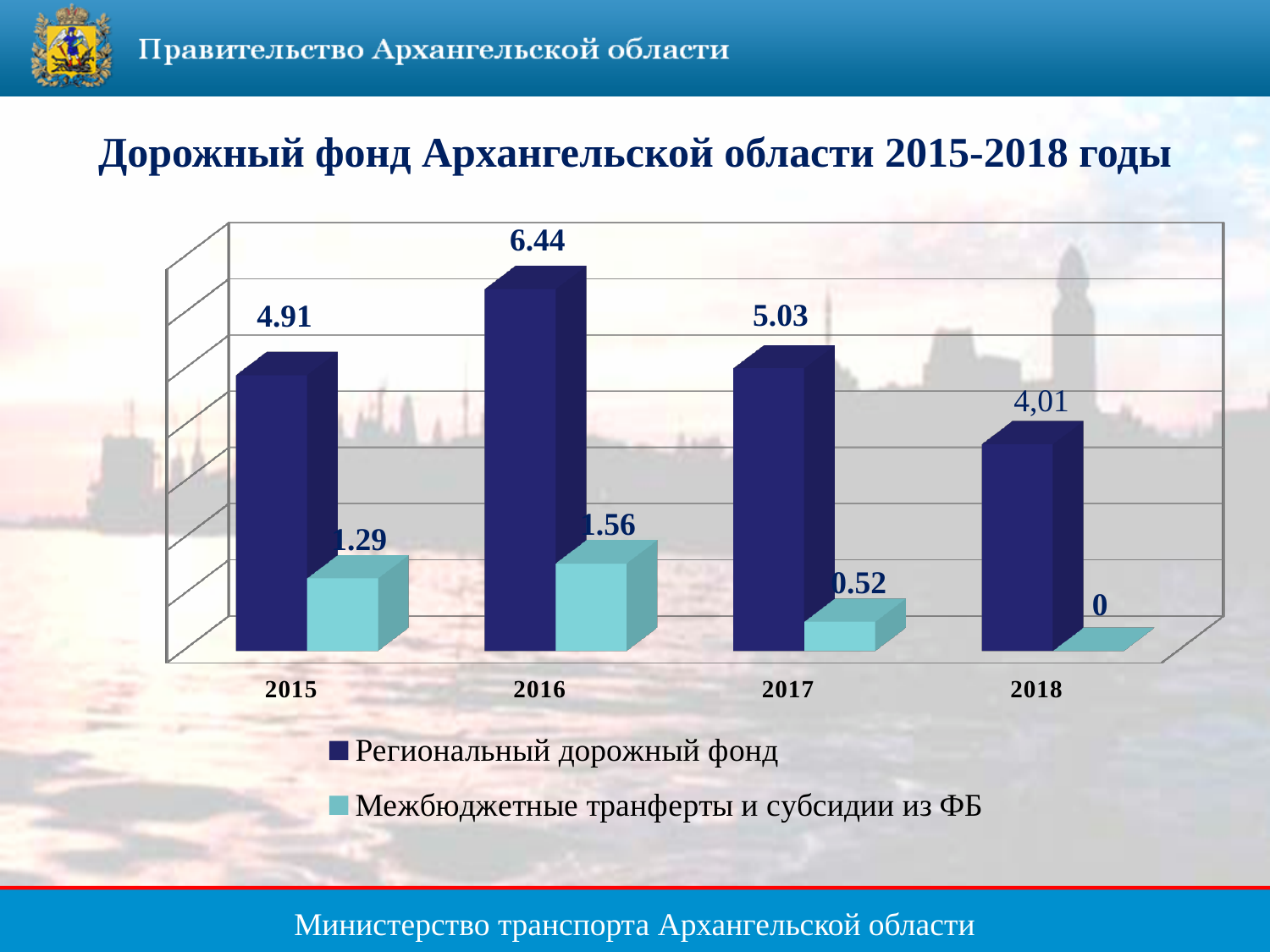
In which year is Региональный дорожный фонд highest? 2016 What is the value of Региональный дорожный фонд for 2016? 6.44 How many series does the legend list? 2 How many years are shown on the x axis? 4 Which is larger: Межбюджетные транферты и субсидии из ФБ in 2015 or in 2016? 2016 What is the value of Региональный дорожный фонд for 2018? 4,01 What is the title of the chart? Дорожный фонд Архангельской области 2015-2018 годы What is the value of Межбюджетные транферты и субсидии из ФБ for 2018? 0 What kind of chart is shown on the slide? Bar chart What is the difference between Региональный дорожный фонд in 2016 and in 2015? 1.53 What is the value of Межбюджетные транферты и субсидии из ФБ for 2017? 0.52 In which year is Межбюджетные транферты и субсидии из ФБ lowest? 2018